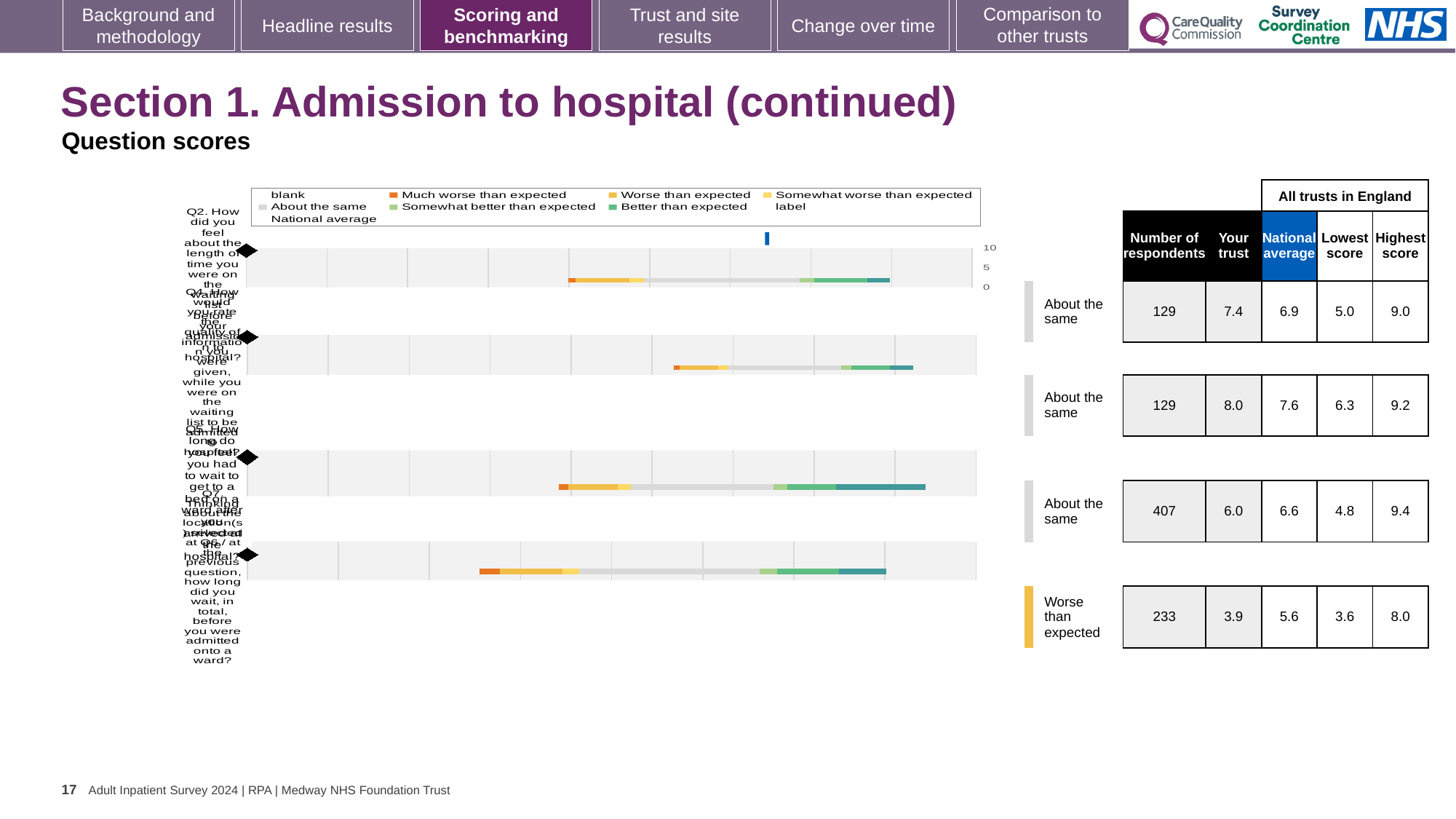
In the table, what is the number of respondents for the first row? 129 Which row of the table has the lowest 'Your trust' score? the fourth row (3.9) In the table, what is the lowest score for the second row? 6.3 In the fourth row of the table, what is the difference between the highest score and the lowest score? 4.4 In the table, what is the highest score for the third row? 9.4 In the table, what is the 'Your trust' score for the fourth (bottom) row? 3.9 What benchmark label is given to the fourth (bottom) row? Worse than expected In the first row of the table, what is the difference between the 'Your trust' score and the national average? 0.5 In the third row of the table, which is larger: the 'Your trust' score or the national average? the national average How many question rows are shown in the table? 4 Which row of the table has the highest 'Your trust' score? the second row (8.0) What kind of chart is shown on the left of the slide? bar chart